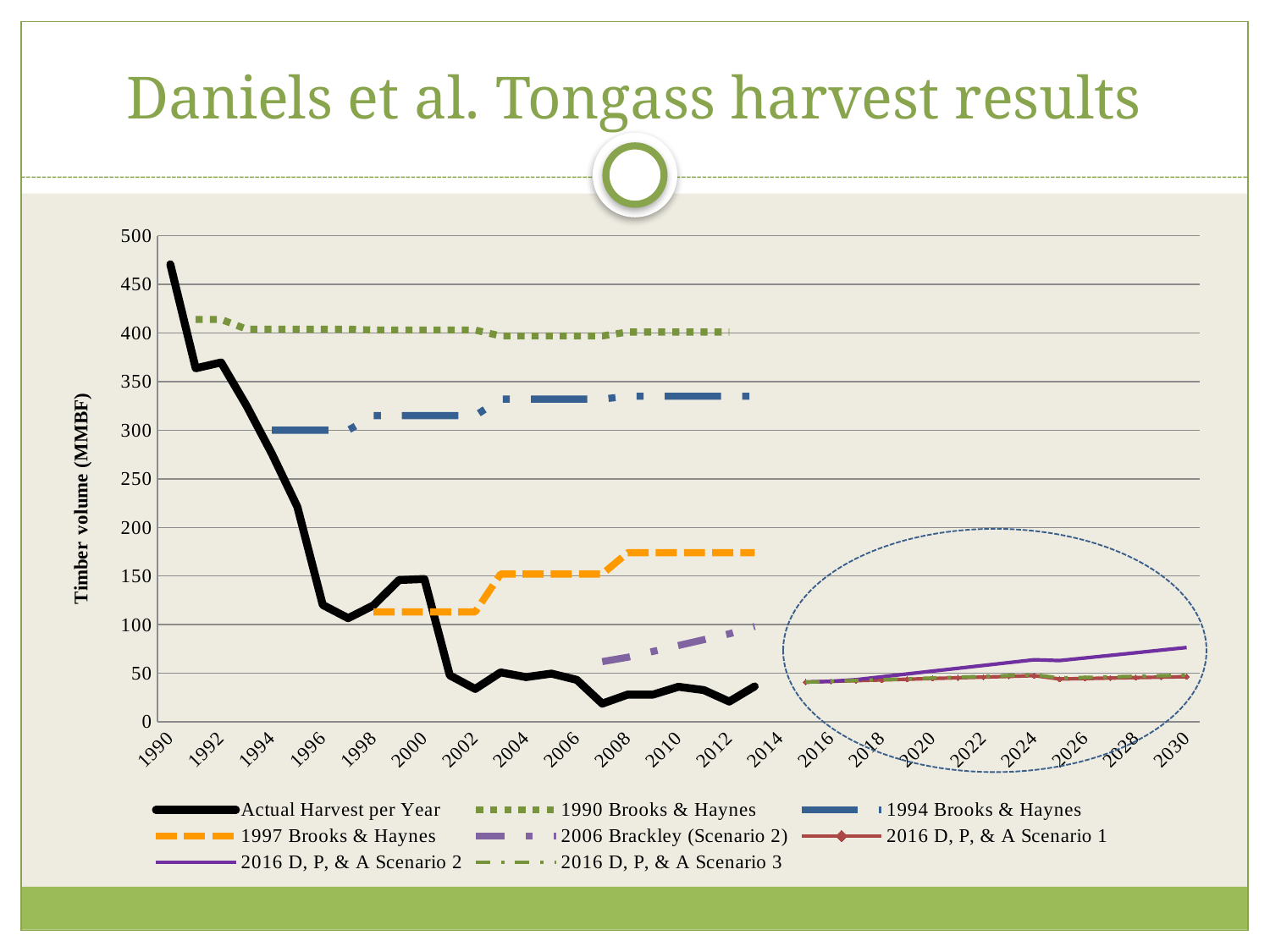
Does the Actual Harvest per Year series generally rise or fall from 1990 to 2012? fall Is the value for 1990 Brooks & Haynes in 2000 greater or less than 350? greater Is the value for 1997 Brooks & Haynes in 2010 greater or less than 200? less What is the title of the slide? Daniels et al. Tongass harvest results Is the value for 1994 Brooks & Haynes in 1994 greater or less than 350? less In 2030, which series has the higher value: 2016 D, P, & A Scenario 2 or 2016 D, P, & A Scenario 1? 2016 D, P, & A Scenario 2 In 2010, which series has the higher value: 1990 Brooks & Haynes or 1997 Brooks & Haynes? 1990 Brooks & Haynes What kind of chart is shown on the slide? line chart How many series does the legend list? 8 What is the label on the vertical axis of the chart? Timber volume (MMBF)